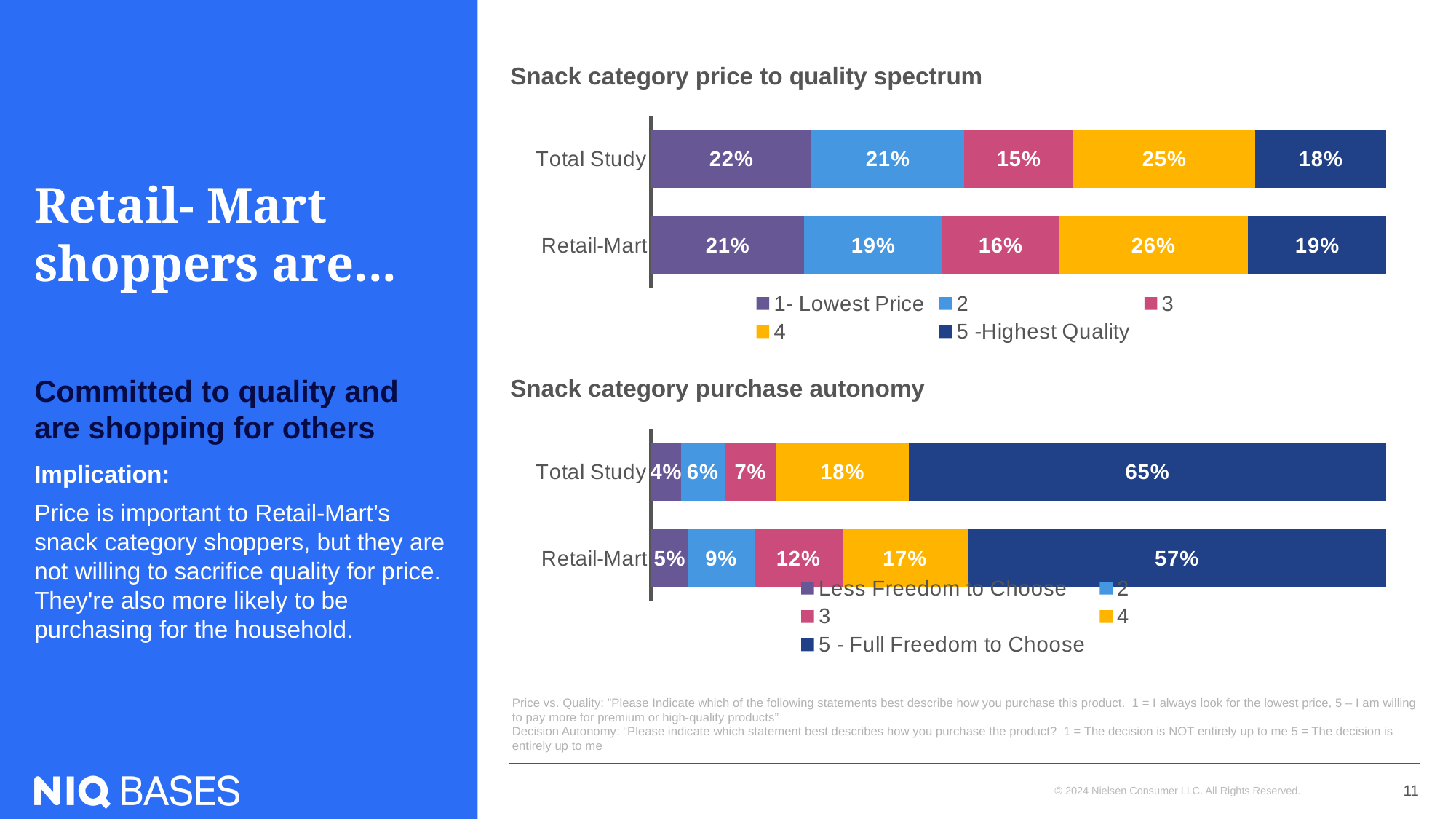
In the 'Snack category purchase autonomy' chart, what is the difference between the '5 - Full Freedom to Choose' values for Total Study and Retail-Mart? 8% In the 'Snack category purchase autonomy' chart, what is the total of the Retail-Mart stacked bar? 100% In the 'Snack category purchase autonomy' chart, which series has the smallest share of the Total Study bar? Less Freedom to Choose In the 'Snack category price to quality spectrum' chart, which is larger: the series '4' value for Total Study or for Retail-Mart? Retail-Mart How many series does the legend of the 'Snack category purchase autonomy' chart list? 5 In the 'Snack category price to quality spectrum' chart, which series has the largest share of the Retail-Mart bar? 4 How many categories (bars) are shown in the 'Snack category price to quality spectrum' chart? 2 In the 'Snack category price to quality spectrum' chart, what is the value for '5 -Highest Quality' for Total Study? 18% In the 'Snack category purchase autonomy' chart, what is the value for series '3' for Total Study? 7% In the 'Snack category price to quality spectrum' chart, what is the value for '1- Lowest Price' for Retail-Mart? 21% In the 'Snack category purchase autonomy' chart, what is the value for '5 - Full Freedom to Choose' for Retail-Mart? 57% What kind of chart is the 'Snack category purchase autonomy' chart? Stacked bar chart